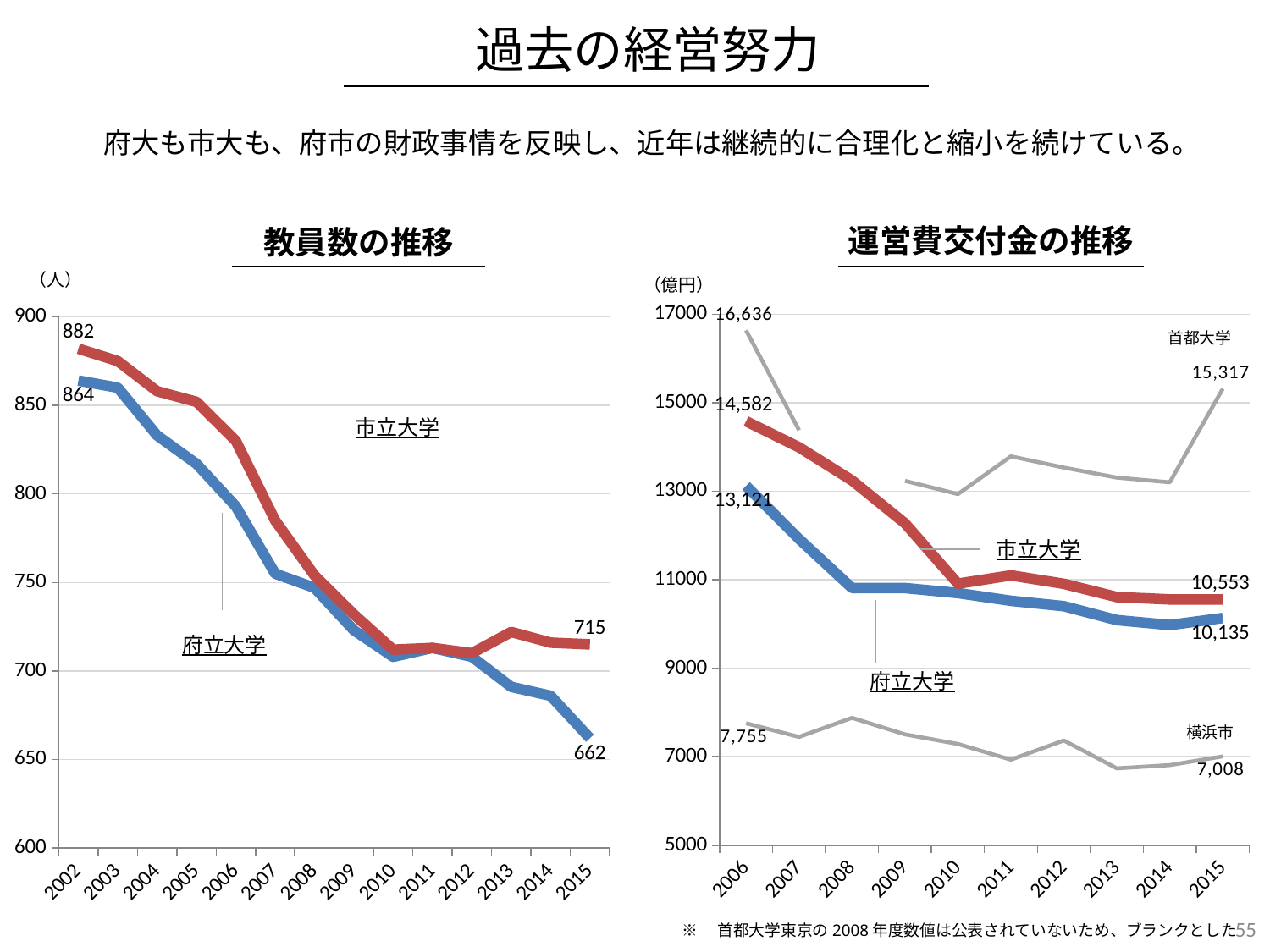
In the 運営費交付金の推移 chart, what is the value for 横浜市 in 2015? 7,008 In the 運営費交付金の推移 chart, what is the value for 首都大学 in 2006? 16,636 What kind of chart is the 運営費交付金の推移 chart? line chart In the 教員数の推移 chart, what is the value for 市立大学 in 2002? 882 In the 教員数の推移 chart, is the value for 府立大学 in 2006 greater or less than 800? less In the 教員数の推移 chart, what is the value for 府立大学 in 2015? 662 In the 運営費交付金の推移 chart, what is the difference between the 2006 and 2015 values for 市立大学? 4,029 In the 教員数の推移 chart, which series has the larger value in 2015, 市立大学 or 府立大学? 市立大学 In the 教員数の推移 chart, what is the difference between the 2002 and 2015 values for 市立大学? 167 In the 教員数の推移 chart, do the values for 府立大学 generally rise or fall from 2002 to 2015? fall In the 運営費交付金の推移 chart, which series has the lowest value in 2015? 横浜市 In the 教員数の推移 chart, how many years are shown on the x axis? 14